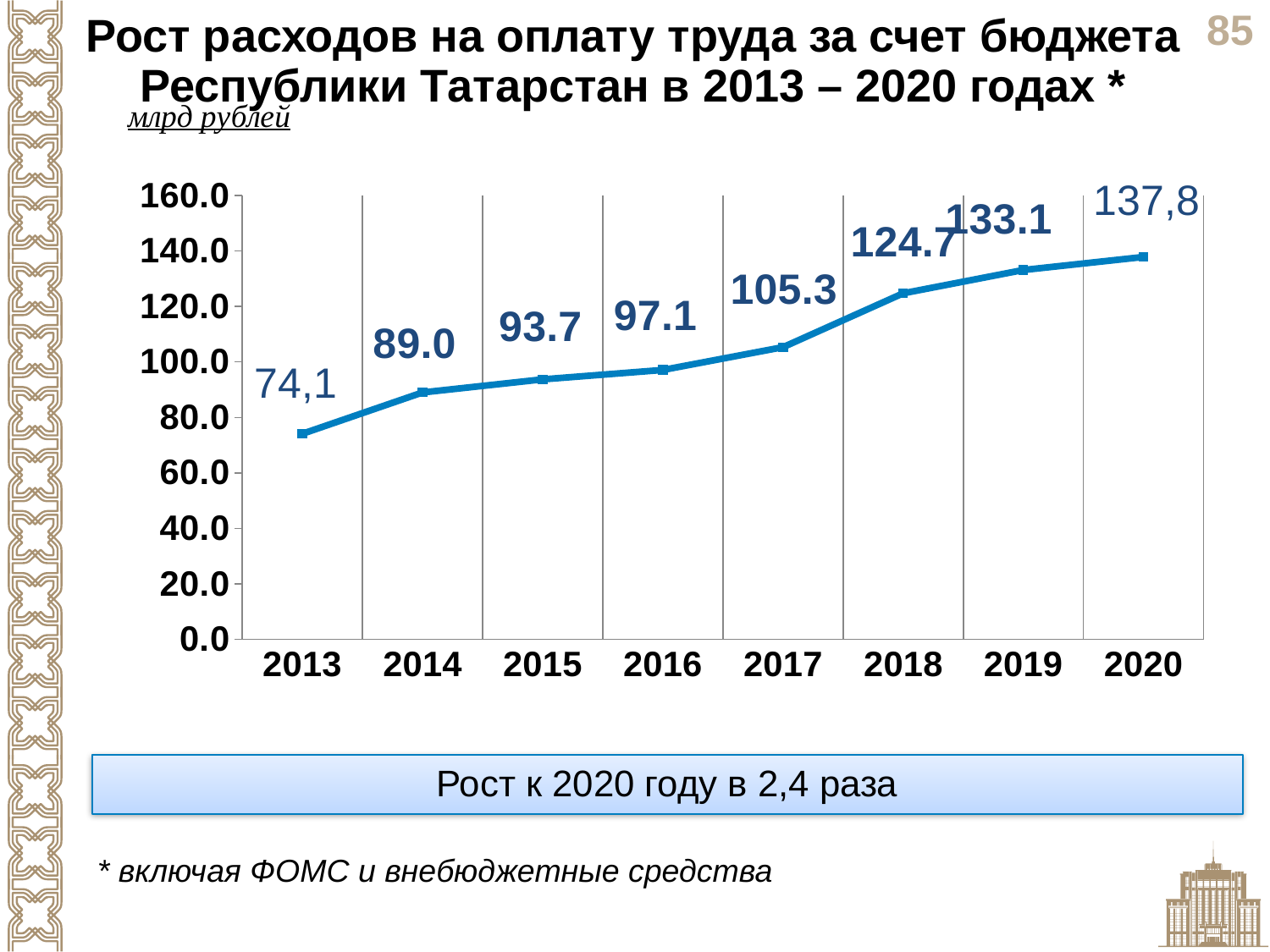
What is the value for 2013? 74,1 What is the difference between the values for 2019 and 2018? 8.4 Which year has the lowest value? 2013 Which is larger, the value for 2015 or the value for 2016? 2016 What is the value for 2018? 124.7 Is the value for 2014 greater or less than 80.0? greater Which year has the highest value? 2020 How many years are plotted on the chart? 8 What kind of chart is shown on the slide? line chart What is the value for 2020? 137,8 Do the values rise or fall from 2013 to 2020? rise What is the value for 2017? 105.3